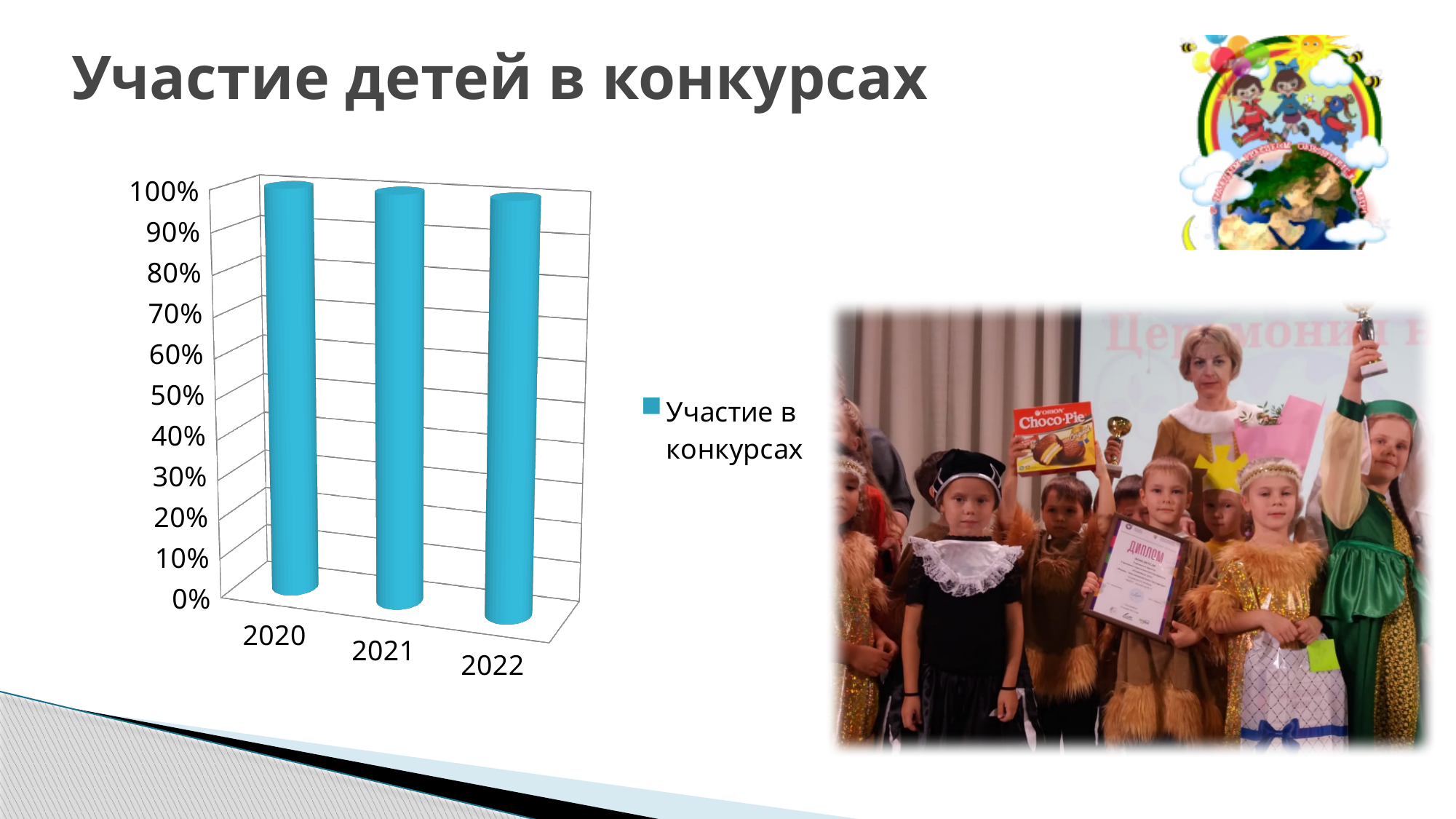
Which years are shown as categories on the chart's x axis? 2020, 2021, 2022 What is the name of the series shown in the chart legend? Участие в конкурсах What is the highest value shown on the chart's y axis? 100% Is the value for 2021 greater or less than 80%? greater What is the title of the slide containing the chart? Участие детей в конкурсах Is the value for 2020 greater or less than 50%? greater How many series does the chart legend list? 1 How many years are shown on the x axis of the chart? 3 Is the value for 2022 greater or less than 70%? greater What kind of chart is shown on the slide? bar chart